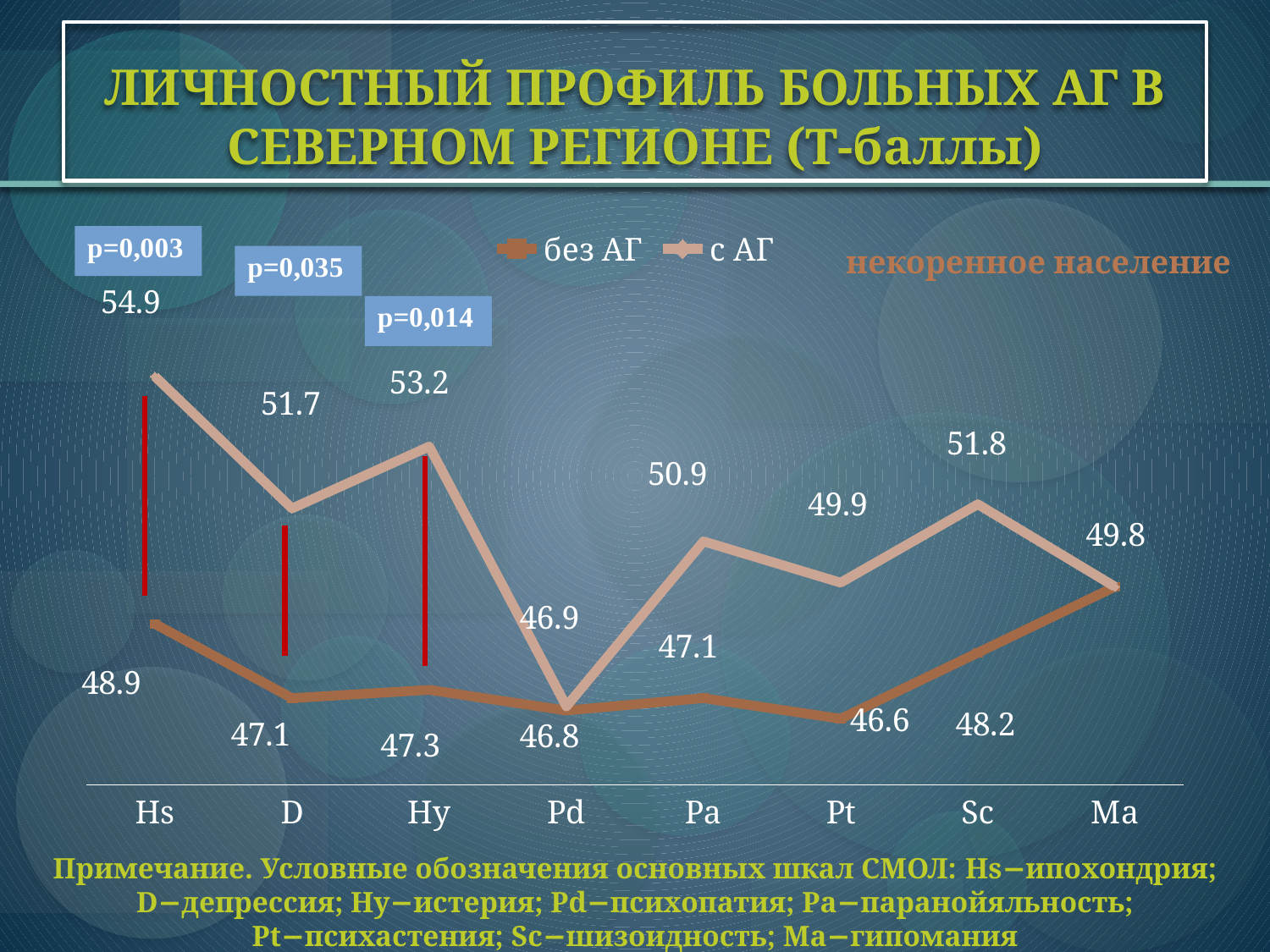
How many scales (categories) are shown on the x axis? 8 For the "с АГ" series, which scale has the highest value? Hs For the "без АГ" series, which scale has the lowest value? Pt At Hy, which series has the larger value, "без АГ" or "с АГ"? с АГ What is the value of the "без АГ" series at Pt? 46.6 What is the value of the "с АГ" series at Hs? 54.9 What is the difference between the "с АГ" and "без АГ" values at Hs? 6.0 What is the value of the "без АГ" series at Sc? 48.2 How many series does the legend list? 2 What is the difference between the "с АГ" values at Hy and D? 1.5 What kind of chart is shown on the slide? Line chart What is the value of the "с АГ" series at Pd? 46.9